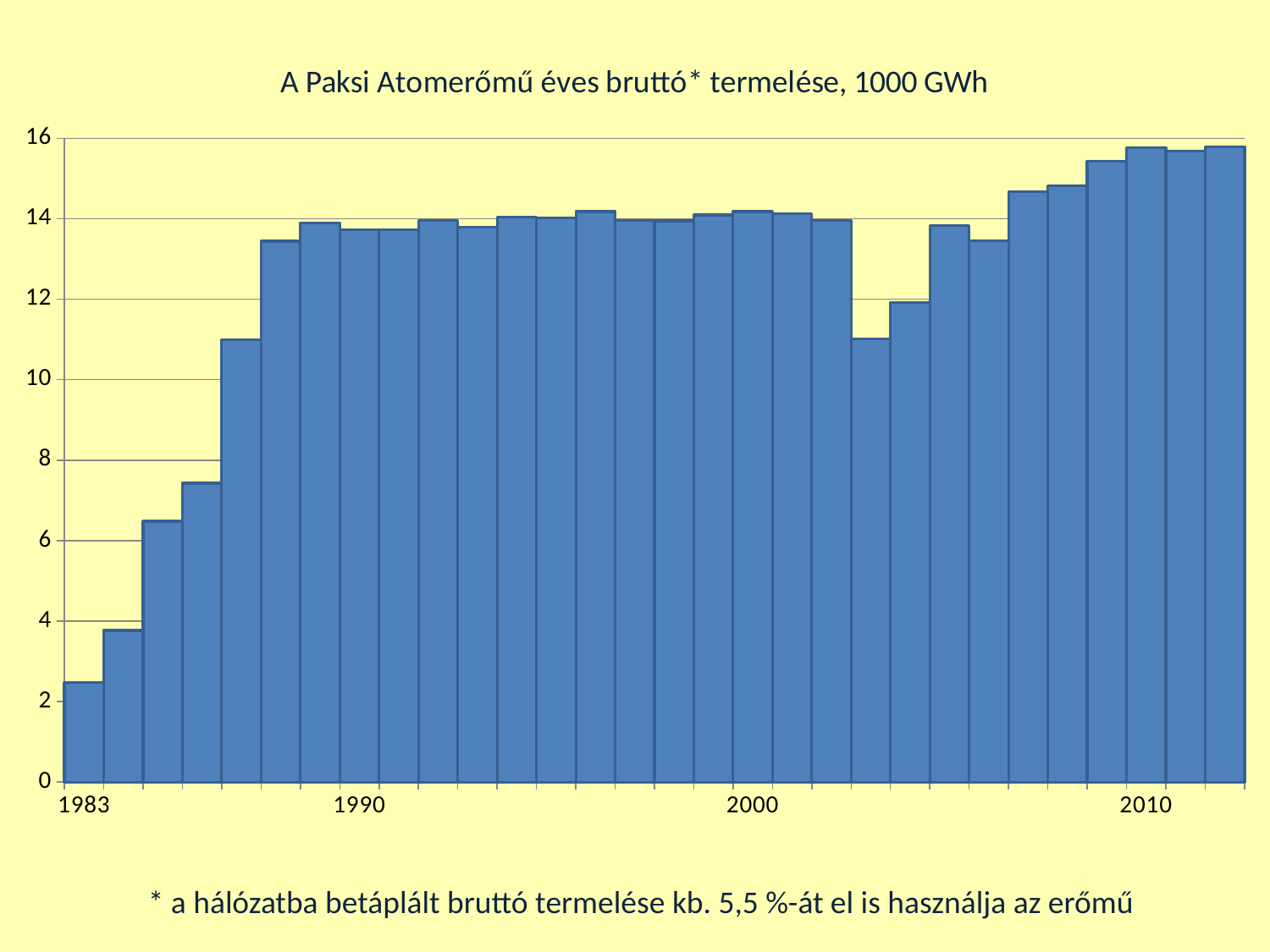
Is the value for 2000 greater or less than 12? greater What kind of chart is shown on the slide? bar chart Which is larger, the value for 1983 or the value for 2010? 2010 Is the value for the lowest bar in the 2000s (the dip after 2000) greater or less than 10? greater What colour are the bars in the chart? blue Is the value for 2010 greater or less than 14? greater Do the values rise or fall from 1983 to 1990? rise What is the title of the chart? A Paksi Atomerőmű éves bruttó* termelése, 1000 GWh Which year has the lowest value in the chart? 1983 How many bars (years) are plotted in the chart? 30